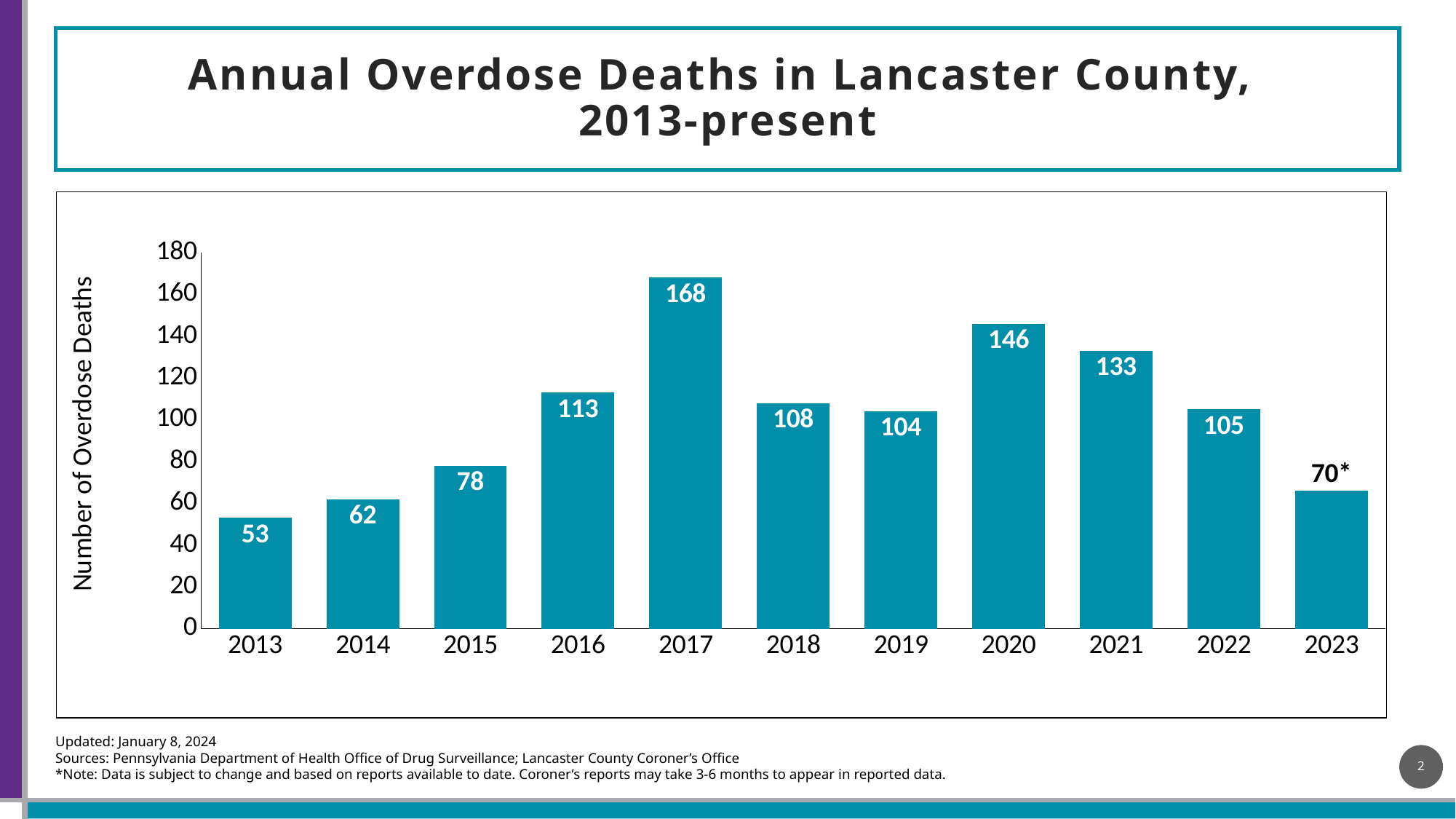
What value is labelled on the bar for 2023? 70* Which year had more overdose deaths, 2016 or 2022? 2016 What is the difference in overdose deaths between 2017 and 2018? 60 Which year has the lowest number of overdose deaths? 2013 Which year has the highest number of overdose deaths? 2017 What is the number of overdose deaths shown for 2013? 53 What is the label of the vertical axis? Number of Overdose Deaths How many overdose deaths were recorded in 2017? 168 Is the value for 2021 greater or less than 120? greater How many years are shown on the x axis? 11 What kind of chart is shown on the slide? Bar chart What is the difference in overdose deaths between 2020 and 2021? 13